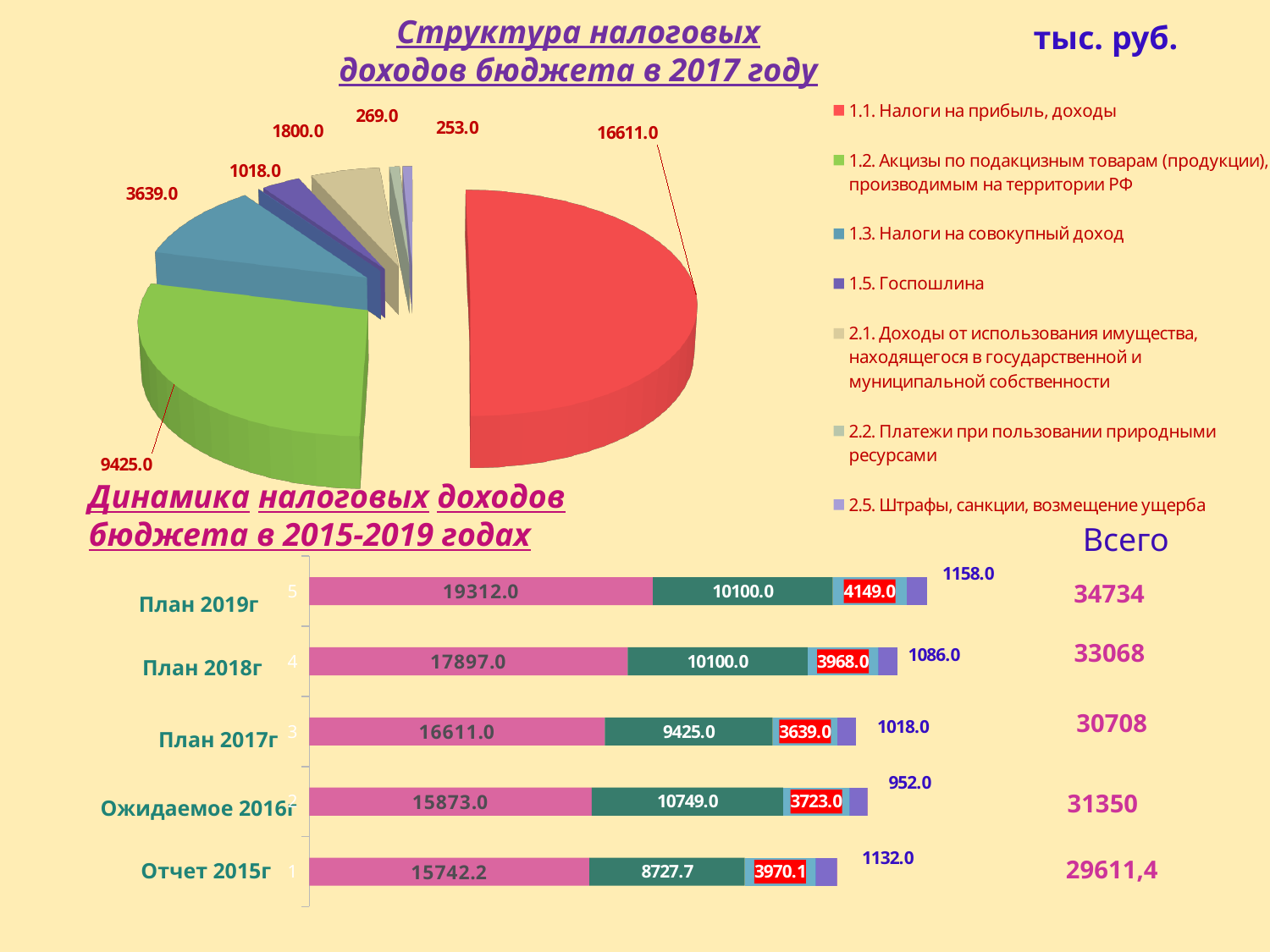
In the bar chart 'Динамика налоговых доходов бюджета в 2015-2019 годах', which is larger: the second (green) segment for 'Ожидаемое 2016г' or for 'План 2017г'? Ожидаемое 2016г In the pie chart 'Структура налоговых доходов бюджета в 2017 году', what is the value for '1.1. Налоги на прибыль, доходы'? 16611.0 In the bar chart 'Динамика налоговых доходов бюджета в 2015-2019 годах', which category has the highest total ('Всего')? План 2019г In the bar chart 'Динамика налоговых доходов бюджета в 2015-2019 годах', what is the value of the first (pink) segment for 'План 2019г'? 19312.0 In the pie chart 'Структура налоговых доходов бюджета в 2017 году', what is the difference between the values for '1.2. Акцизы по подакцизным товарам' and '1.3. Налоги на совокупный доход'? 5786.0 In the pie chart 'Структура налоговых доходов бюджета в 2017 году', which category has the smallest slice? 2.5. Штрафы, санкции, возмещение ущерба In the bar chart 'Динамика налоговых доходов бюджета в 2015-2019 годах', how many categories (bars) are shown? 5 In the pie chart 'Структура налоговых доходов бюджета в 2017 году', what is the value for '1.3. Налоги на совокупный доход'? 3639.0 In the pie chart 'Структура налоговых доходов бюджета в 2017 году', which category has the largest slice? 1.1. Налоги на прибыль, доходы In the bar chart 'Динамика налоговых доходов бюджета в 2015-2019 годах', what is the total ('Всего') for 'Отчет 2015г'? 29611,4 What type of chart is 'Динамика налоговых доходов бюджета в 2015-2019 годах'? Stacked bar chart In the pie chart 'Структура налоговых доходов бюджета в 2017 году', how many categories does the legend list? 7